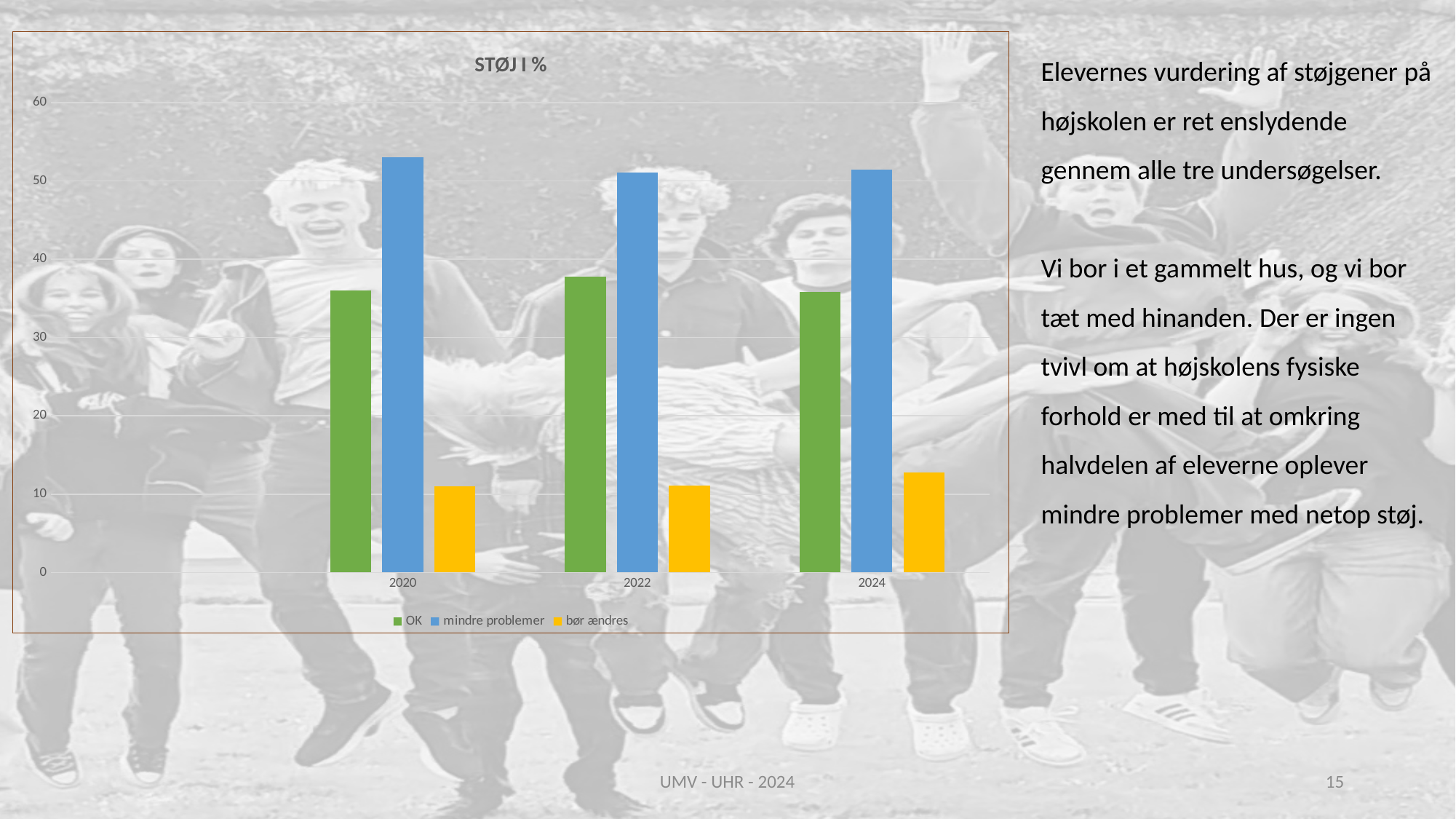
What kind of chart is shown on the slide? bar chart Is the value for bør ændres in 2024 greater or less than 20? less How many years are shown on the x axis of the chart? 3 How many series does the legend list? 3 Is the value for mindre problemer in 2020 greater or less than 50? greater Which is larger in 2024, the value for OK or the value for bør ændres? OK Is the value for OK in 2022 greater or less than 40? less Which series is shown in blue in the chart? mindre problemer What is the title of the chart? STØJ I % Which series has the lowest value in 2022? bør ændres Which series has the highest value in 2020? mindre problemer In which year is the value for bør ændres highest? 2024